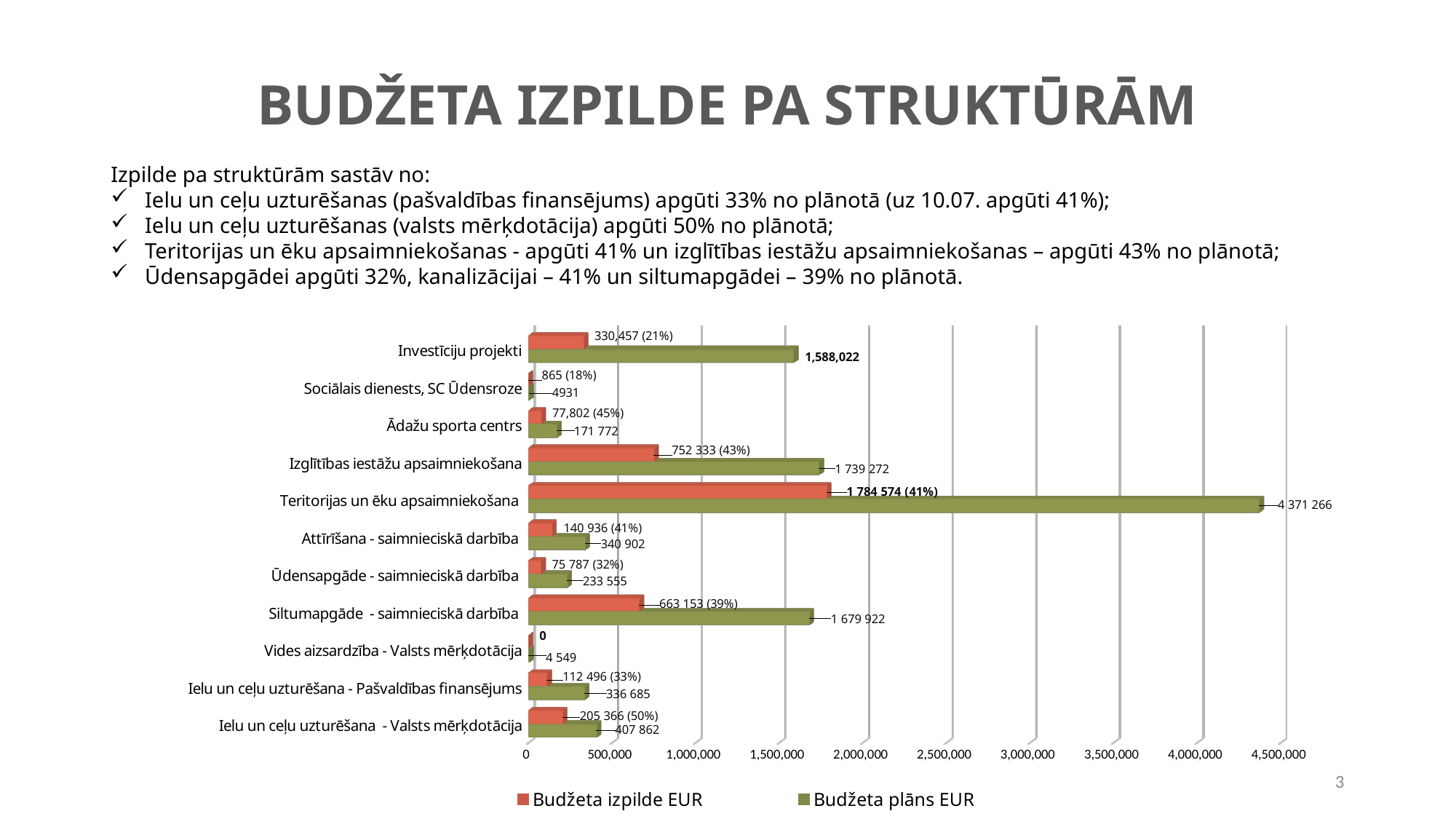
Which series is shown in green in the chart? Budžeta plāns EUR What is the Budžeta plāns EUR value for Investīciju projekti? 1,588,022 Which category has the highest Budžeta plāns EUR value? Teritorijas un ēku apsaimniekošana How many categories are shown on the chart? 11 What is the difference between the Budžeta plāns EUR and Budžeta izpilde EUR values for Attīrīšana - saimnieciskā darbība? 199 966 What is the Budžeta izpilde EUR value for Vides aizsardzība - Valsts mērķdotācija? 0 What is the Budžeta plāns EUR value for Teritorijas un ēku apsaimniekošana? 4 371 266 Which is larger: the Budžeta izpilde EUR value for Izglītības iestāžu apsaimniekošana or for Siltumapgāde - saimnieciskā darbība? Izglītības iestāžu apsaimniekošana Which category has the lowest Budžeta izpilde EUR value? Vides aizsardzība - Valsts mērķdotācija What type of chart is shown on the slide? bar chart What is the Budžeta izpilde EUR value for Siltumapgāde - saimnieciskā darbība? 663 153 How many series does the legend list? 2